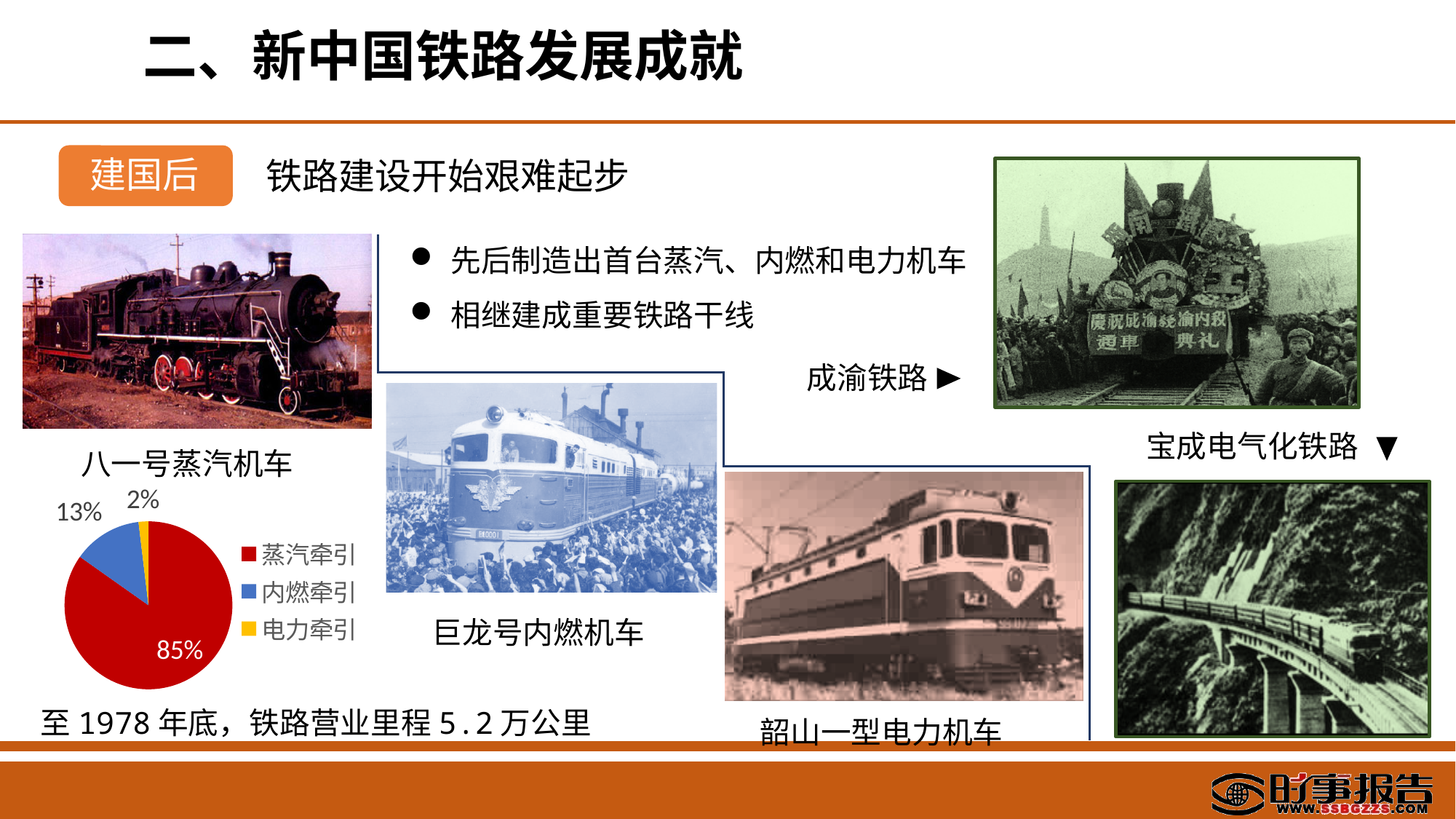
How many slices does the pie chart have? 3 What colour is the 蒸汽牵引 slice in the pie chart? red What is the difference in percentage points between 蒸汽牵引 and 内燃牵引 in the pie chart? 72 What share of the pie chart does 电力牵引 account for? 2% What kind of chart is shown at the bottom left of the slide? pie chart Which is larger in the pie chart, 内燃牵引 or 电力牵引? 内燃牵引 What is the difference in percentage points between 内燃牵引 and 电力牵引 in the pie chart? 11 How many entries does the pie chart's legend list? 3 What share of the pie chart does 蒸汽牵引 account for? 85% What share of the pie chart does 内燃牵引 account for? 13% Which category has the smallest slice in the pie chart? 电力牵引 Which category has the largest slice in the pie chart? 蒸汽牵引